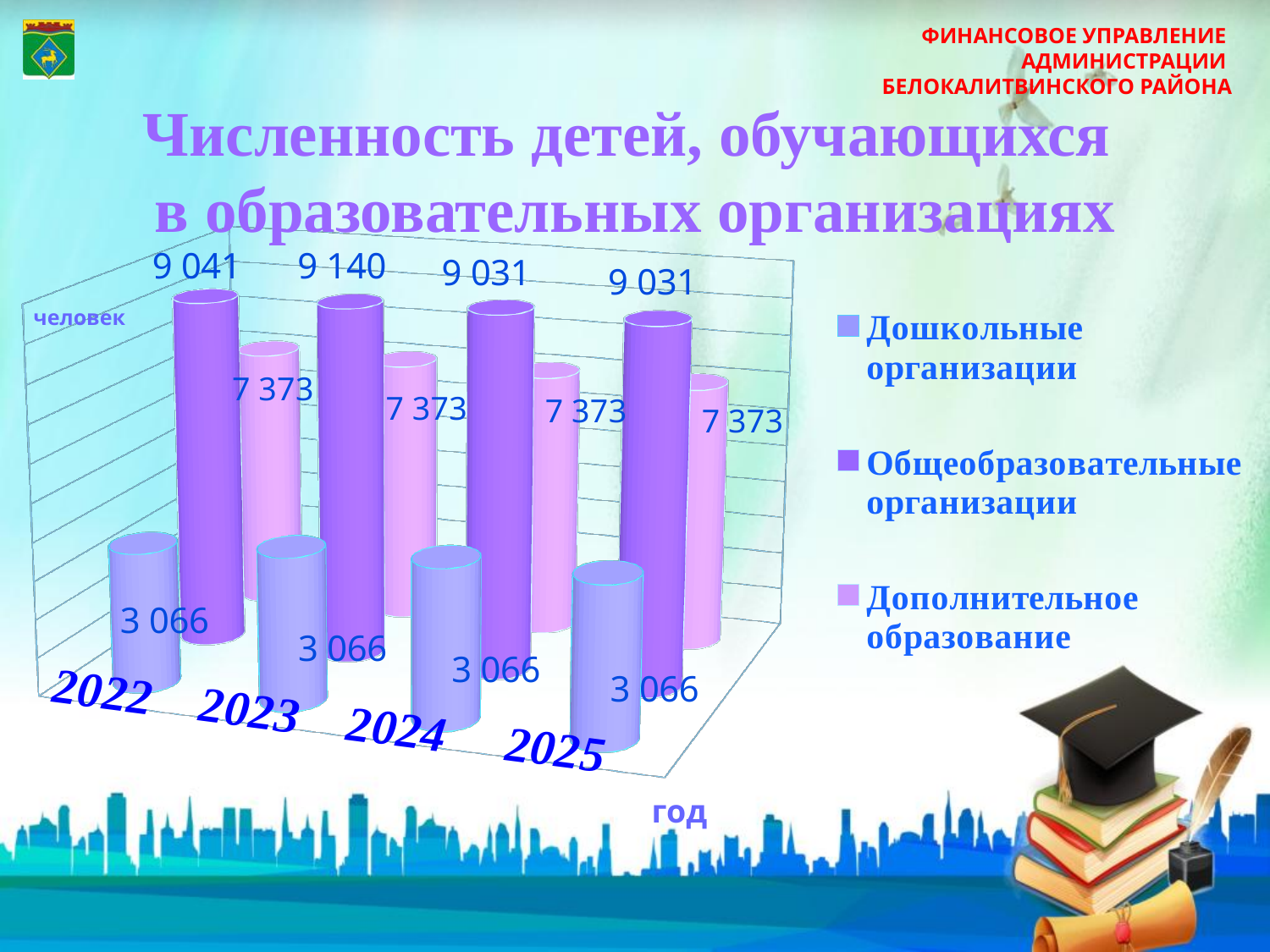
What kind of chart is shown on the slide? bar chart In 2022, which is larger: Общеобразовательные организации or Дополнительное образование? Общеобразовательные организации Do the values for Дошкольные организации rise, fall or stay the same from 2022 to 2025? stay the same What is the value for Общеобразовательные организации in 2023? 9 140 What is the total of the three series for 2022? 19 480 What is the value for Дошкольные организации in 2022? 3 066 What unit label is shown on the vertical axis of the chart? человек In which year is the value for Общеобразовательные организации highest? 2023 How many series does the legend list? 3 What is the difference between the Общеобразовательные организации values for 2023 and 2022? 99 What is the value for Дополнительное образование in 2025? 7 373 How many years are shown on the x axis? 4